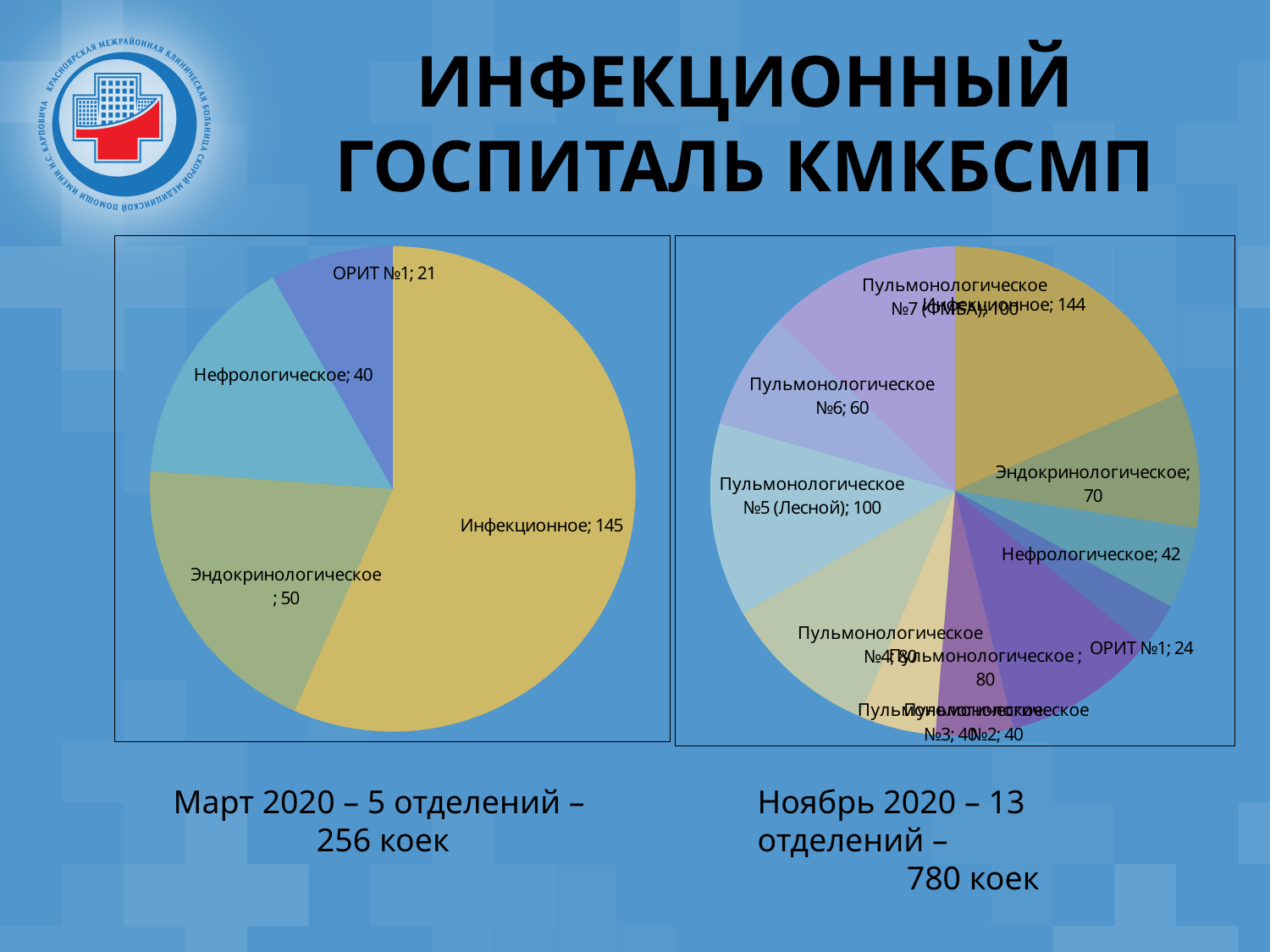
In the left pie chart (Март 2020), which department has the smallest slice? ОРИТ №1 What type of chart is used on this slide? Pie chart In the right pie chart (Ноябрь 2020), what is the value for ОРИТ №1? 24 In the right pie chart (Ноябрь 2020), which is larger: Эндокринологическое or Пульмонологическое №6? Эндокринологическое In the left pie chart (Март 2020), what is the value for Нефрологическое? 40 In the right pie chart (Ноябрь 2020), what is the value for Эндокринологическое? 70 In the left pie chart (Март 2020), what is the value for ОРИТ №1? 21 In the left pie chart (Март 2020), what is the difference between the values for Инфекционное and Эндокринологическое? 95 In the right pie chart (Ноябрь 2020), what is the value for Пульмонологическое №5 (Лесной)? 100 In the left pie chart (Март 2020), how many beds does the Инфекционное department have? 145 In the left pie chart (Март 2020), which department has the largest slice? Инфекционное What is the difference between the Эндокринологическое value in the right chart (Ноябрь 2020) and in the left chart (Март 2020)? 20